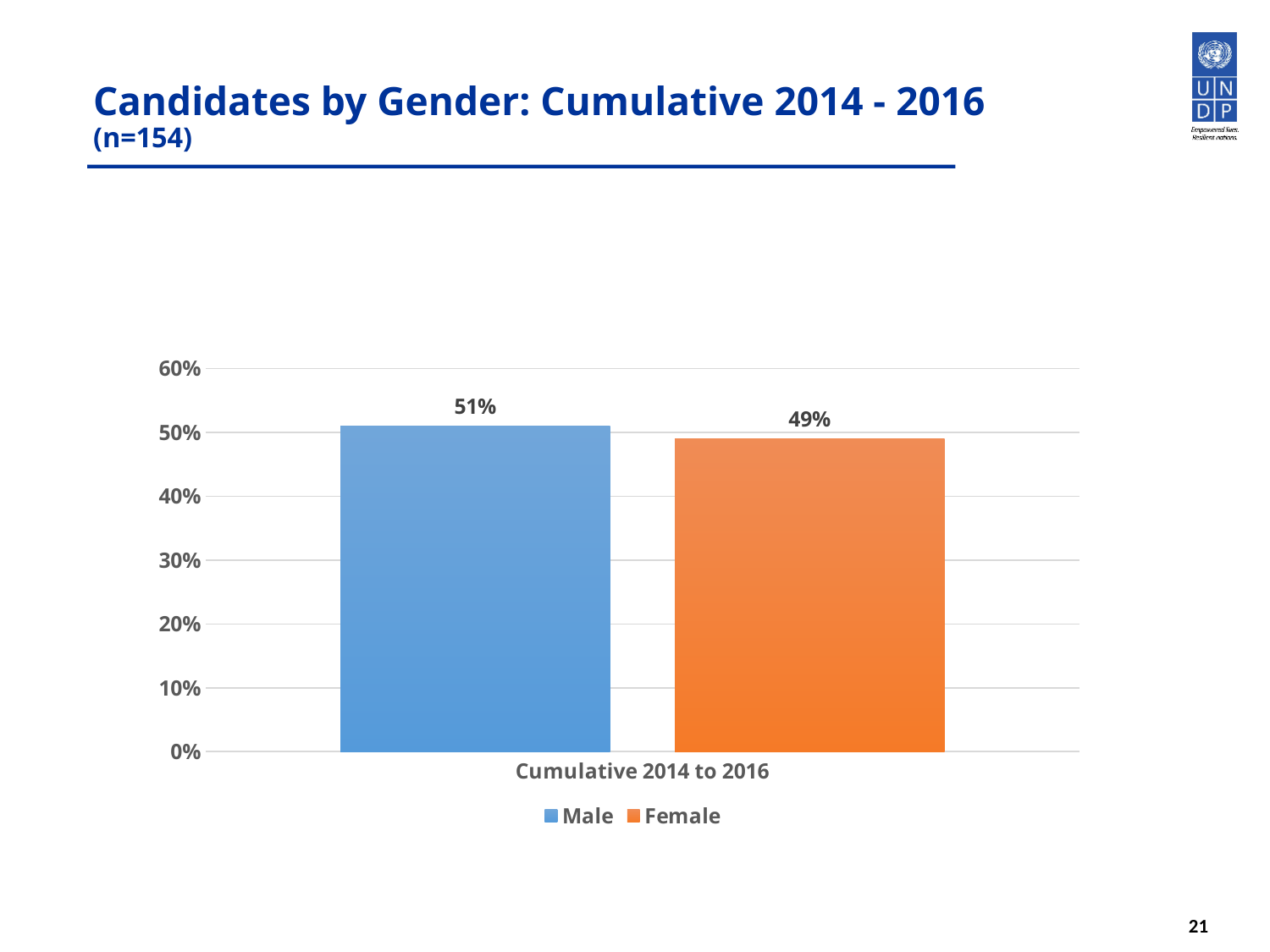
What is the total of the male and female percentages? 100% What is the sample size (n) stated in the slide title? 154 Which gender has the higher share of candidates? Male Is the value for Male greater or less than 50%? greater How many series does the legend list? 2 What is the difference between the male and female percentages? 2% What kind of chart is shown on the slide? Bar chart What percentage of candidates were male? 51% What percentage of candidates were female? 49% Which gender has the lower share of candidates? Female Is the value for Female greater or less than 50%? less What colour represents Female in the chart? Orange